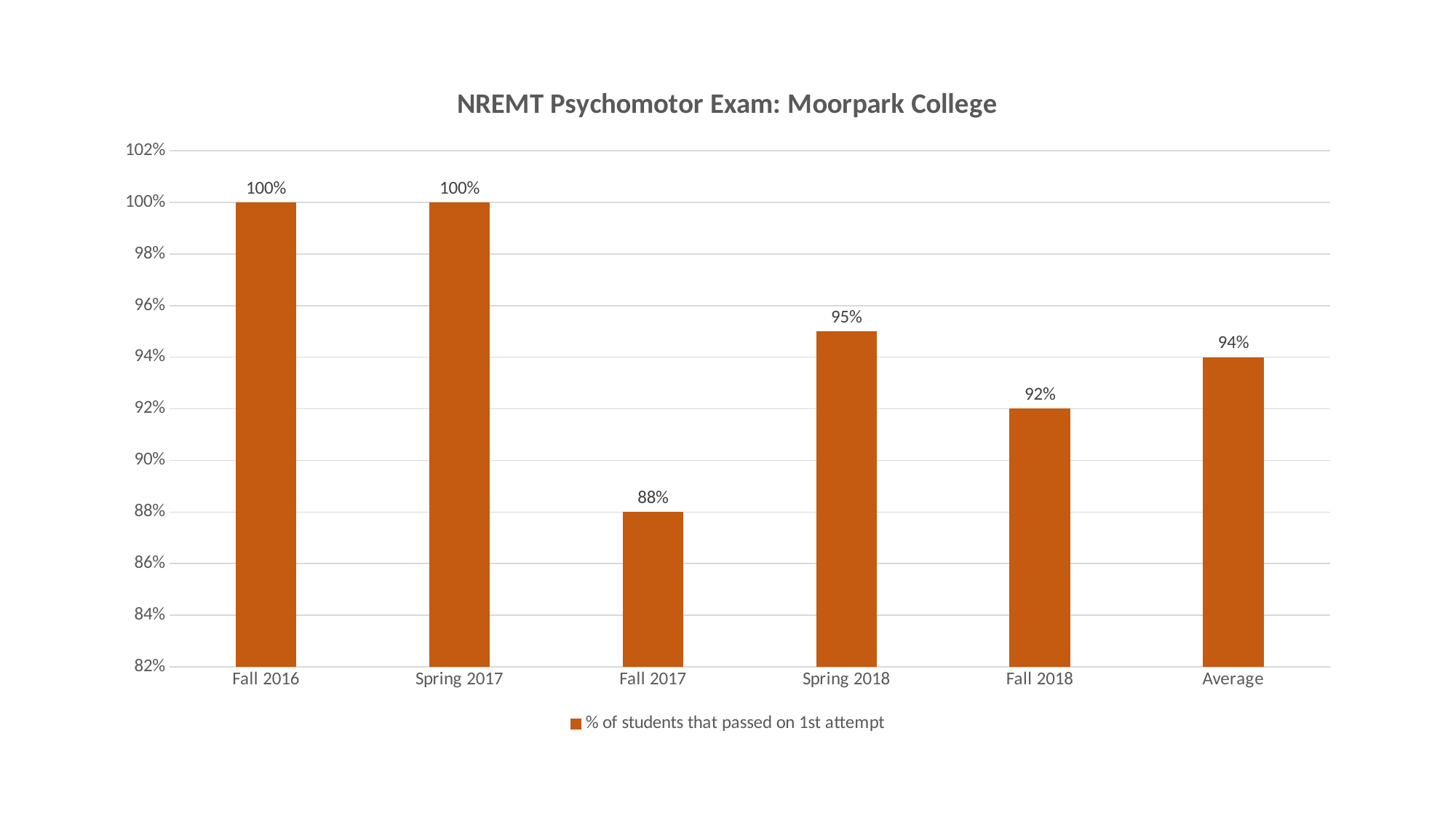
What is the Average value shown on the chart? 94% What is the value shown for Spring 2018? 95% What is the title of the chart? NREMT Psychomotor Exam: Moorpark College Which category has the lowest pass rate? Fall 2017 How many series does the legend list? 1 What kind of chart is shown on the slide? Bar chart What is the difference between the Spring 2017 and Fall 2017 pass rates? 12% What percentage of students passed on the 1st attempt in Fall 2017? 88% Which is larger, the value for Spring 2018 or the value for Fall 2018? Spring 2018 How many categories are shown on the x axis? 6 What is the difference between the Spring 2018 and Fall 2018 values? 3% What percentage of students passed on the 1st attempt in Fall 2018? 92%